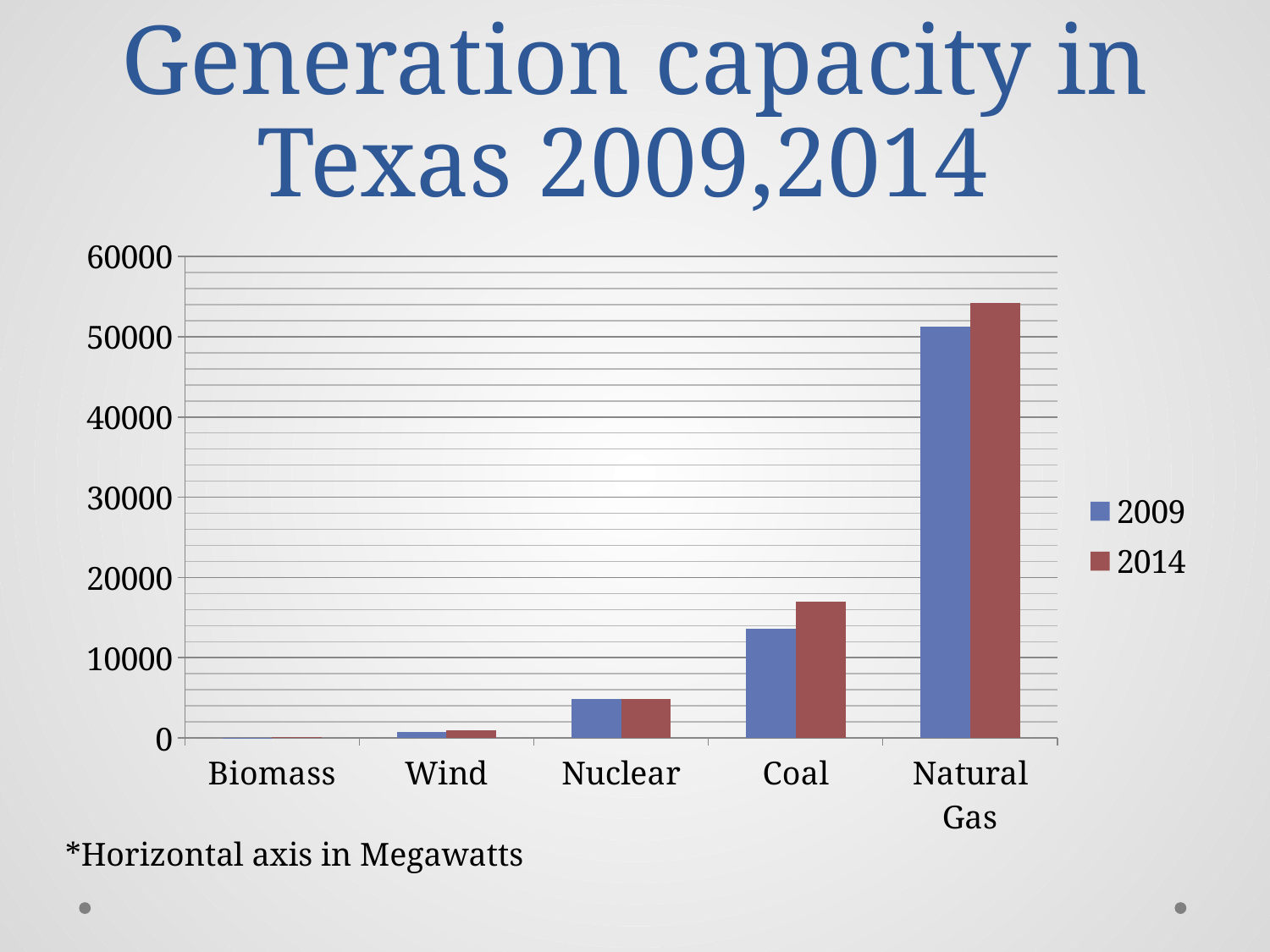
What kind of chart is shown on the slide? bar chart Which category has the larger 2009 capacity, Coal or Nuclear? Coal What is the title of the chart? Generation capacity in Texas 2009,2014 For Coal, which year has the larger generation capacity, 2009 or 2014? 2014 Which category has the lowest generation capacity in 2009? Biomass Which colour represents the 2014 series in the legend? red Which category has the highest generation capacity in 2014? Natural Gas How many series does the legend list? 2 How many categories are shown on the x axis? 5 Is the value for Coal in 2014 greater or less than 20000? less Is the value for Natural Gas in 2014 greater or less than 50000? greater Is the value for Nuclear in 2009 greater or less than 10000? less